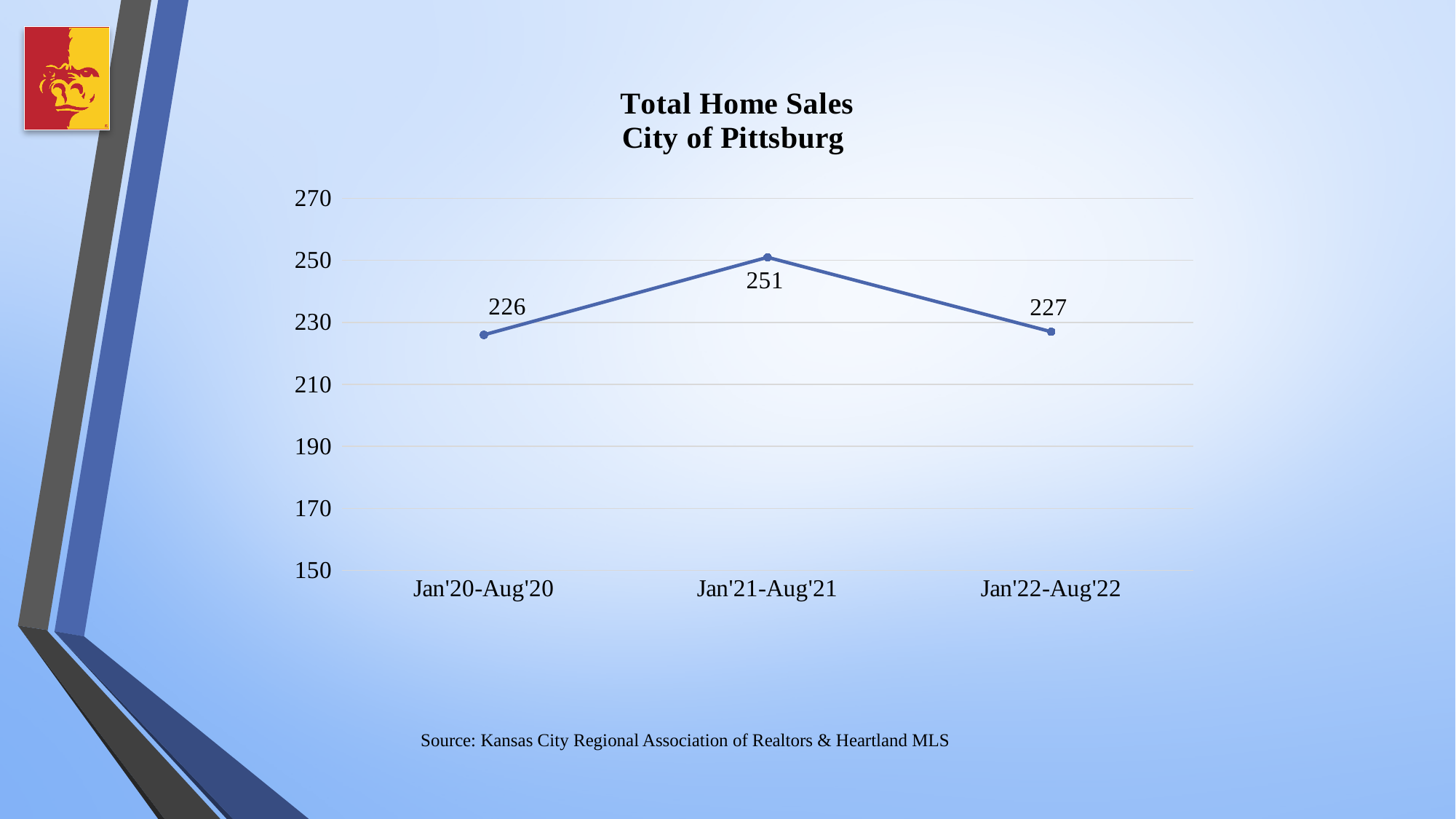
Which period has the highest total home sales? Jan'21-Aug'21 What is the value for Jan'20-Aug'20? 226 What is the value for Jan'21-Aug'21? 251 What is the difference between the values for Jan'21-Aug'21 and Jan'22-Aug'22? 24 How many periods are plotted on the chart? 3 Is the value for Jan'21-Aug'21 greater or less than 250? greater What is the value for Jan'22-Aug'22? 227 Which period has the lowest total home sales? Jan'20-Aug'20 Which is larger, the value for Jan'21-Aug'21 or the value for Jan'22-Aug'22? Jan'21-Aug'21 What is the difference between the values for Jan'21-Aug'21 and Jan'20-Aug'20? 25 What is the title of the chart? Total Home Sales City of Pittsburg What kind of chart is shown on the slide? line chart